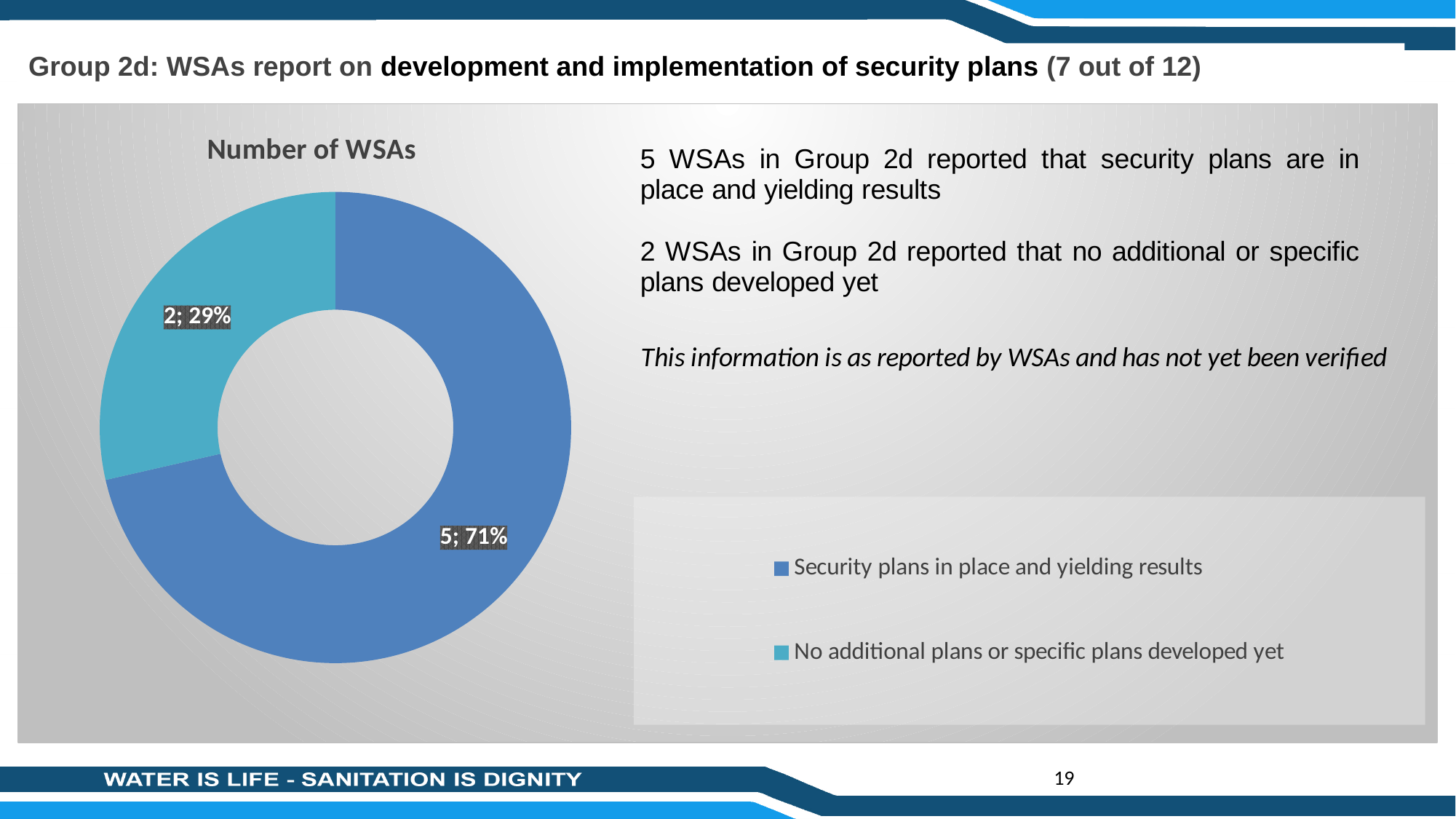
What kind of chart is shown on the slide? Pie chart (doughnut) Which category has the largest slice? Security plans in place and yielding results What is the title of the chart? Number of WSAs What share of the pie is 'Security plans in place and yielding results'? 71% What share of the pie is 'No additional plans or specific plans developed yet'? 29% How many categories does the chart show? 2 How many WSAs reported no additional plans or specific plans developed yet? 2 Which category has the smallest slice? No additional plans or specific plans developed yet Which is larger: the slice for 'Security plans in place and yielding results' or the slice for 'No additional plans or specific plans developed yet'? Security plans in place and yielding results What is the difference in the number of WSAs between 'Security plans in place and yielding results' and 'No additional plans or specific plans developed yet'? 3 What is the total number of WSAs represented in the chart? 7 How many WSAs reported that security plans are in place and yielding results? 5